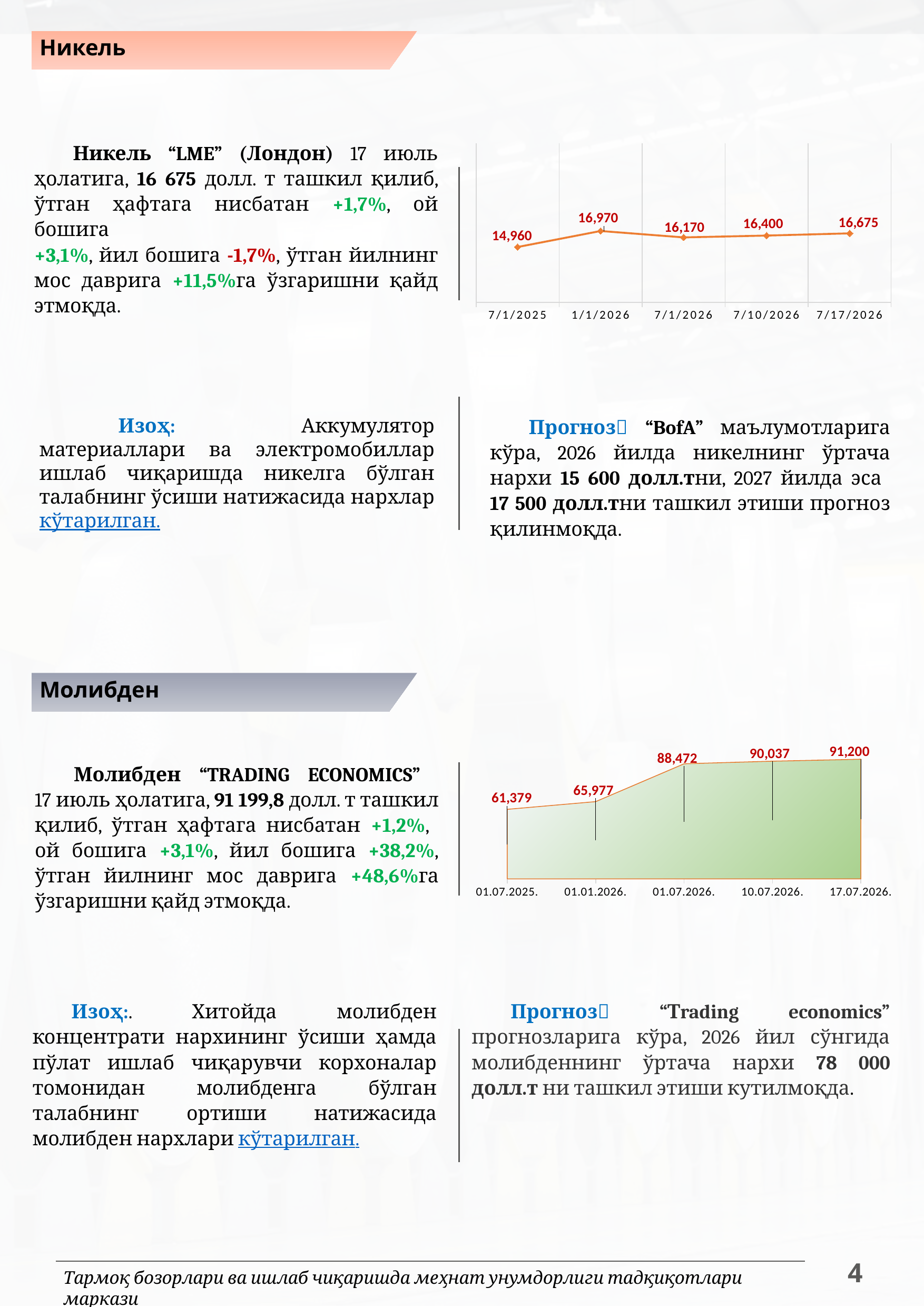
What kind of chart is the top chart (Никель section)? line chart In the top chart (Никель section), what is the value at 7/1/2025? 14,960 In the top chart (Никель section), which date has the highest value? 1/1/2026 In the bottom chart (Молибден section), what is the value at 01.07.2026? 88,472 In the bottom chart (Молибден section), do the values rise or fall from left to right along the x axis? rise In the top chart (Никель section), which date has the lowest value? 7/1/2025 In the top chart (Никель section), what is the difference between the values at 1/1/2026 and 7/1/2026? 800 In the bottom chart (Молибден section), which is larger: the value at 01.01.2026 or at 10.07.2026? 10.07.2026. In the bottom chart (Молибден section), what is the difference between the values at 17.07.2026 and 01.07.2025? 29,821 In the top chart (Никель section), how many data points are plotted? 5 In the bottom chart (Молибден section), which date has the highest value? 17.07.2026. In the top chart (Никель section), what is the value at 7/17/2026? 16,675